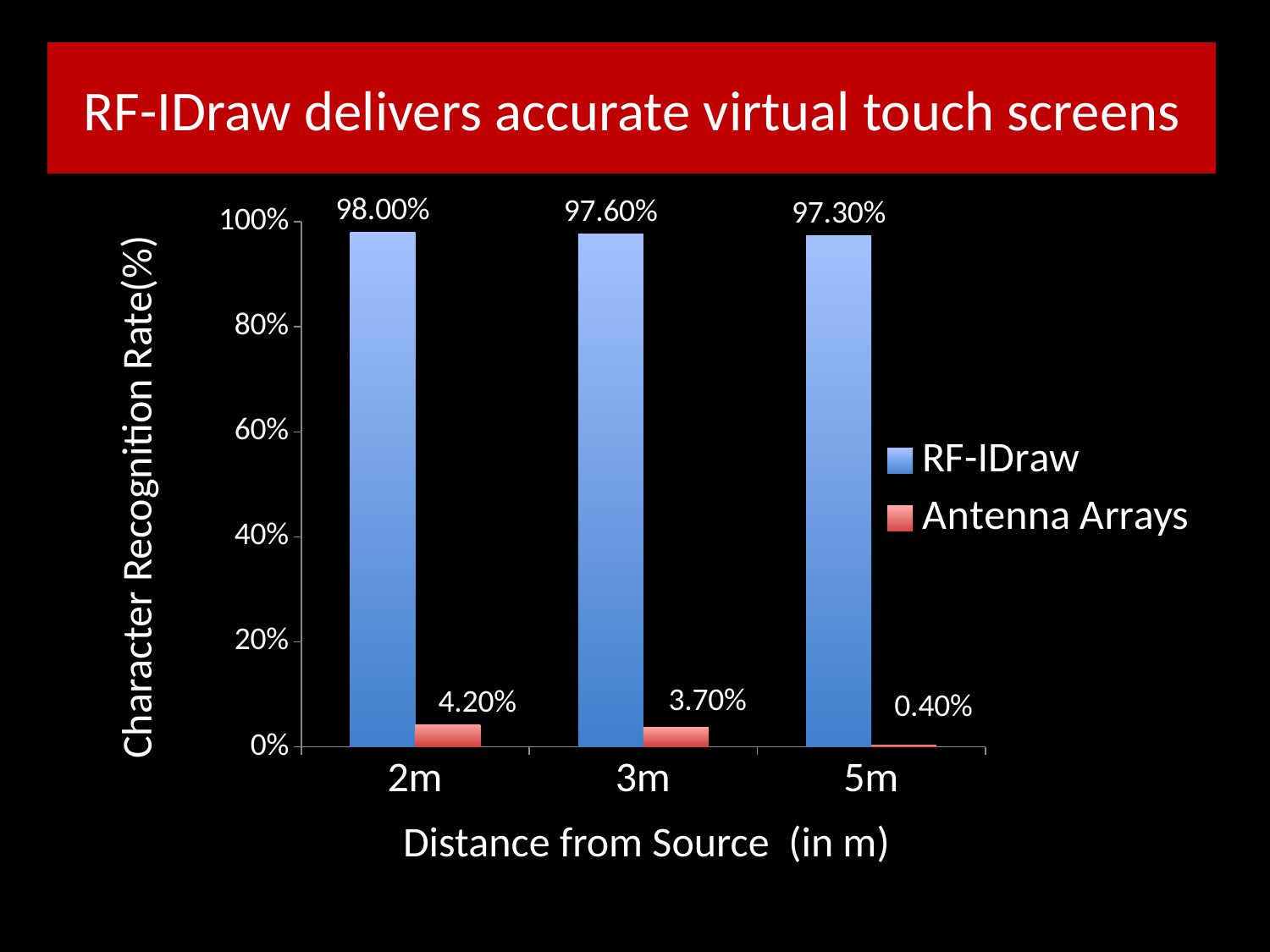
What kind of chart is shown on the slide? bar chart Which series has the larger recognition rate at 3m, RF-IDraw or Antenna Arrays? RF-IDraw Is the RF-IDraw value at 5m greater or less than 80%? greater At which distance is the Antenna Arrays recognition rate lowest? 5m At which distance is the RF-IDraw recognition rate highest? 2m What is the character recognition rate for Antenna Arrays at 3m? 3.70% What is the difference between the RF-IDraw and Antenna Arrays recognition rates at 2m? 93.80% What is the character recognition rate for Antenna Arrays at 5m? 0.40% What is the character recognition rate for RF-IDraw at 2m? 98.00% How many distance categories are shown on the x axis? 3 What is the label of the y axis? Character Recognition Rate(%) How many series does the legend list? 2